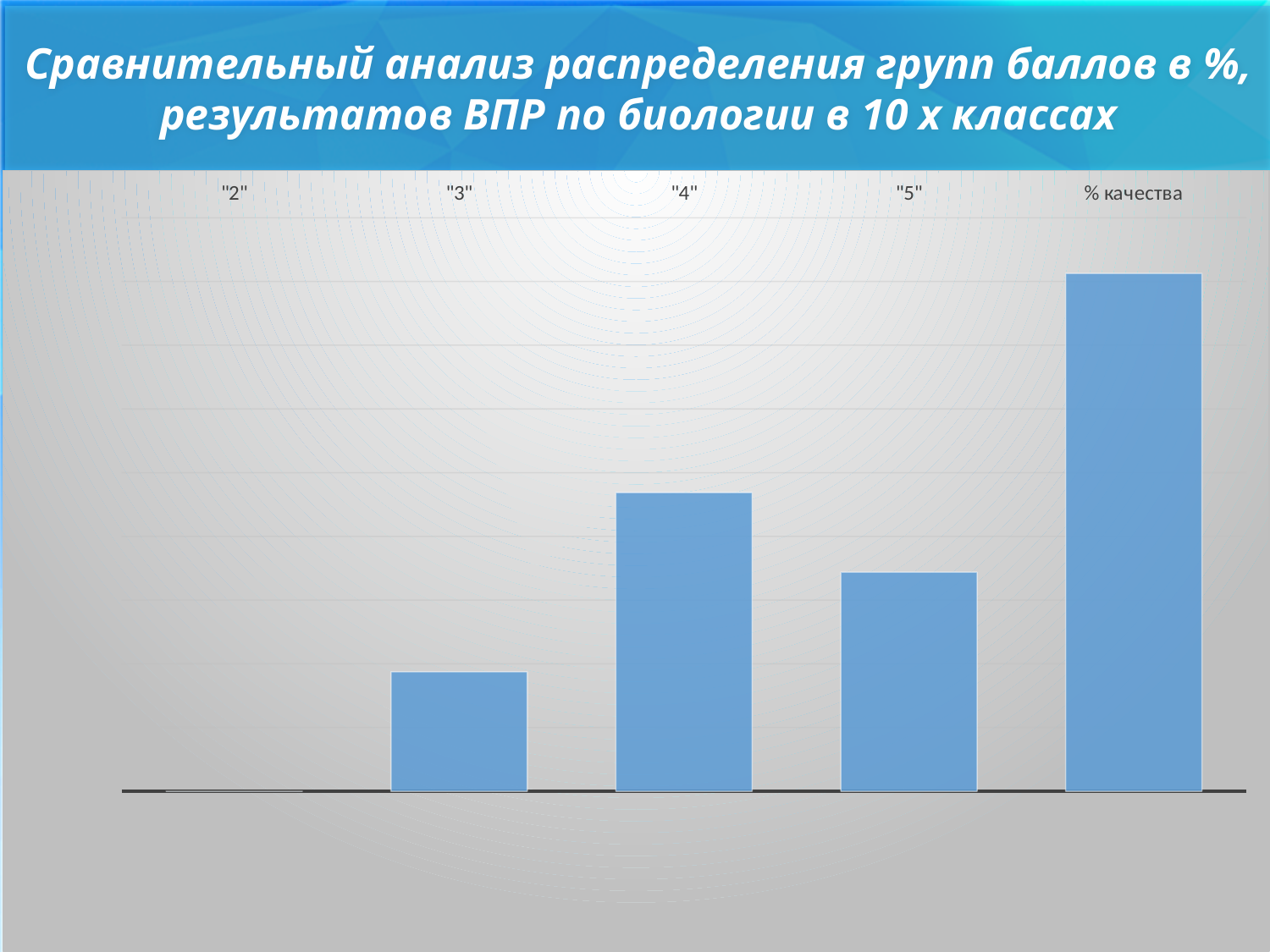
Which is larger, the value for "5" or the value for "% качества"? % качества Which is larger, the value for "4" or the value for "5"? "4" What is the label of the rightmost category on the x axis? % качества What is the title of the slide containing the chart? Сравнительный анализ распределения групп баллов в %, результатов ВПР по биологии в 10 х классах Which is larger, the value for "3" or the value for "4"? "4" Which category has the lowest value in the chart? "2" How many categories are shown on the x axis of the chart? 5 What kind of chart is shown on the slide? bar chart Which category has the second-highest bar in the chart? "4" Which category has the highest bar in the chart? % качества